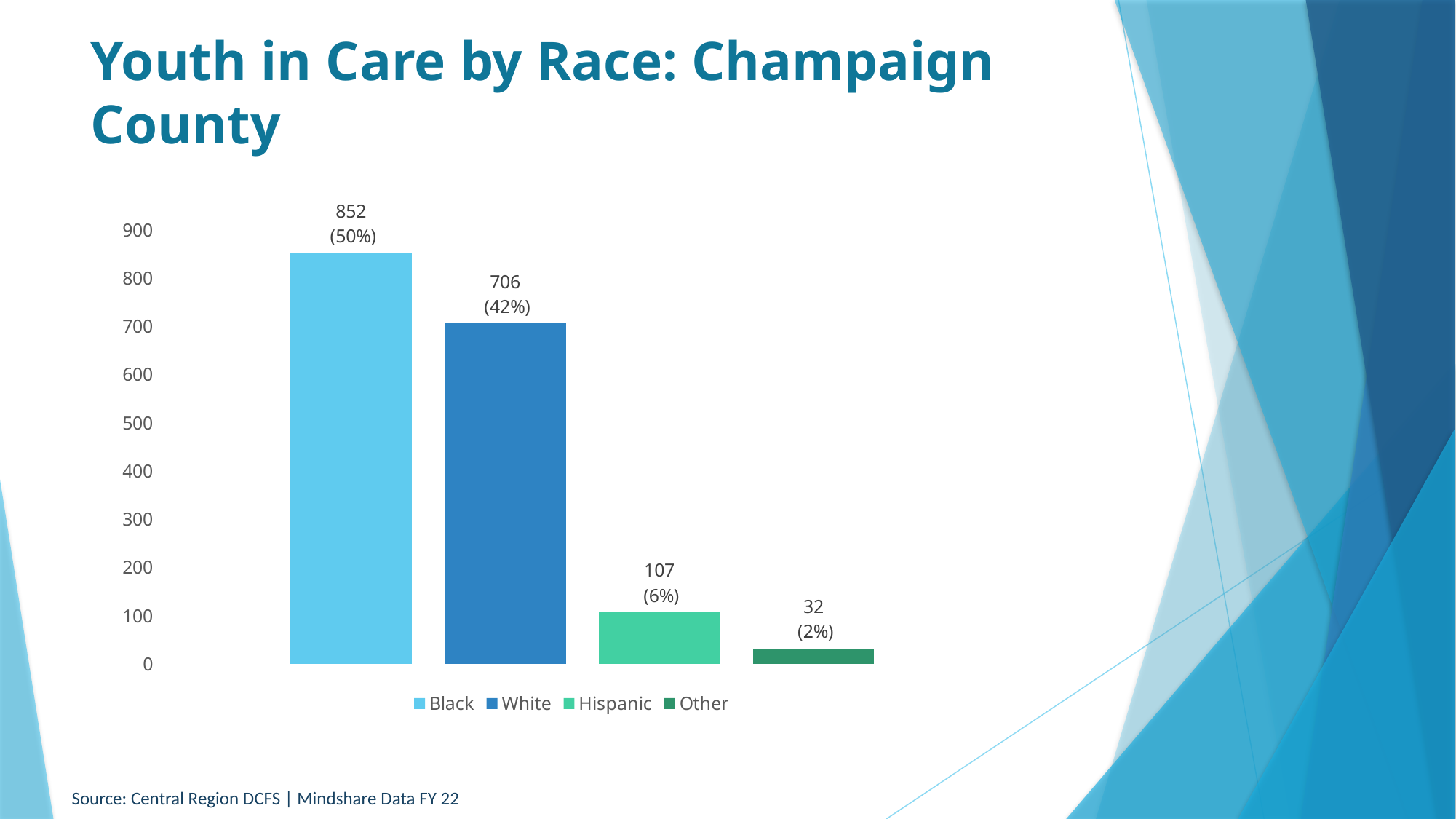
What is the value for White? 706 Which is larger, the value for Hispanic or the value for Other? Hispanic What is the value for Hispanic? 107 Is the value for White greater or less than 600? greater What is the difference between the Black and White values? 146 How many categories are shown in the chart? 4 Which category has the highest number of youth in care? Black How many youth in care are Black? 852 What kind of chart is shown on the slide? Bar chart Which category has the lowest number of youth in care? Other What percentage of youth in care are in the Other category? 2% What is the source cited for the chart data? Central Region DCFS | Mindshare Data FY 22